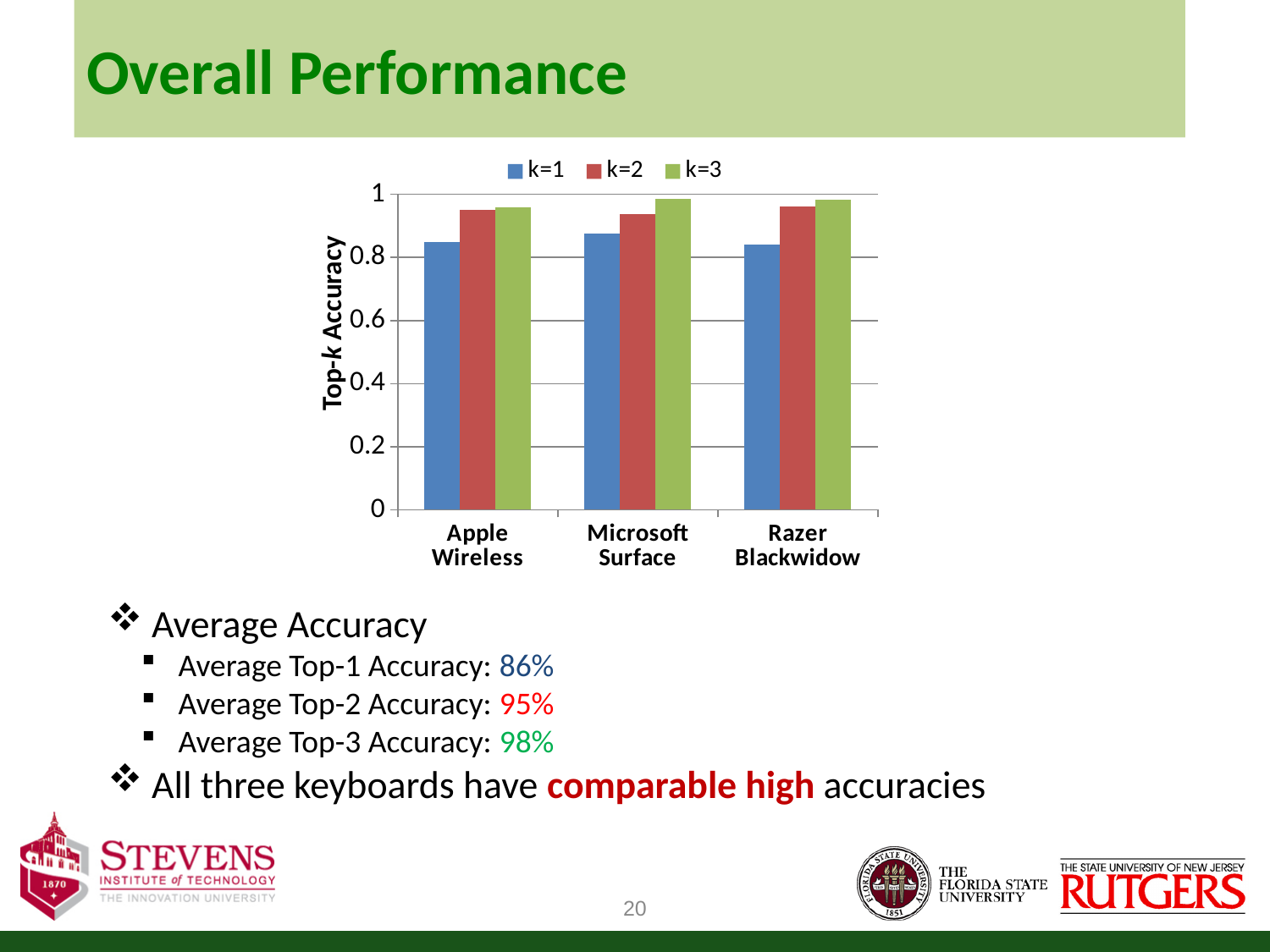
What kind of chart is shown on the slide? bar chart For Apple Wireless, which is larger: the k=1 value or the k=2 value? k=2 What is the label of the chart's y axis? Top-k Accuracy For Microsoft Surface, do the values rise or fall going from k=1 to k=3? rise How many keyboard categories are shown on the x axis of the chart? 3 Is the k=1 value for Apple Wireless greater or less than 0.8? greater Is the k=3 value for Razer Blackwidow greater or less than 0.8? greater Is the k=1 value for Razer Blackwidow greater or less than 0.6? greater How many series does the chart's legend list? 3 What are the series names listed in the chart's legend? k=1, k=2, k=3 Which keyboard has the highest k=1 value? Microsoft Surface Which is larger: the k=1 value for Microsoft Surface or the k=1 value for Razer Blackwidow? Microsoft Surface